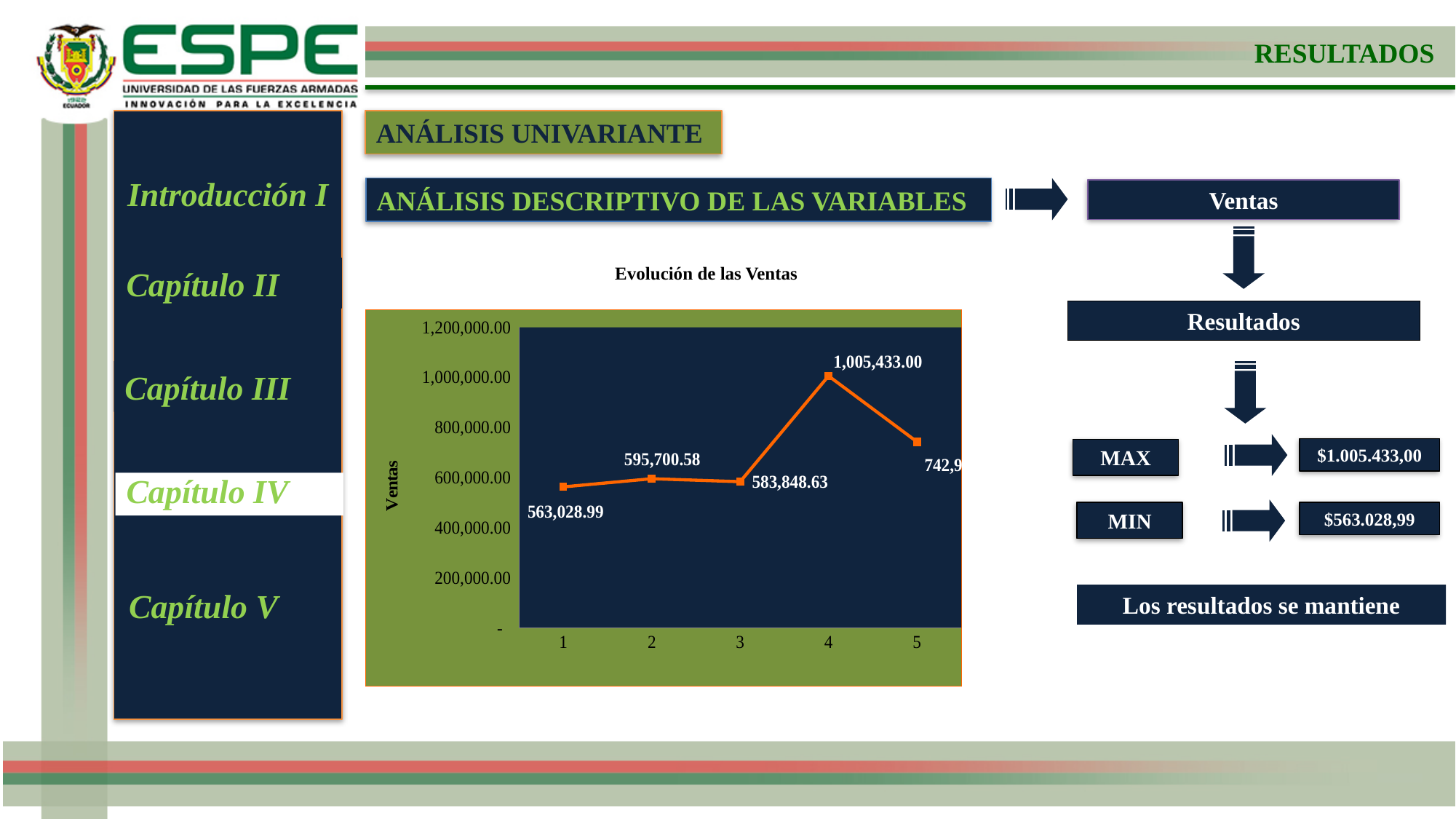
Is the value for point 5 in the Evolución de las Ventas chart greater or less than 600,000.00? greater What is the value for point 1 in the Evolución de las Ventas chart? 563,028.99 What is the difference between the values at point 4 and point 1 in the Evolución de las Ventas chart? 442,404.01 Does the value rise or fall from point 4 to point 5 in the Evolución de las Ventas chart? Fall Which point on the x axis has the lowest value in the Evolución de las Ventas chart? 1 Which point on the x axis has the highest value in the Evolución de las Ventas chart? 4 What is the value for point 3 in the Evolución de las Ventas chart? 583,848.63 What is the value for point 2 in the Evolución de las Ventas chart? 595,700.58 What kind of chart is the Evolución de las Ventas chart? Line chart What is the value for point 4 in the Evolución de las Ventas chart? 1,005,433.00 How many points are plotted in the Evolución de las Ventas chart? 5 Which has the larger value in the Evolución de las Ventas chart, point 2 or point 3? Point 2